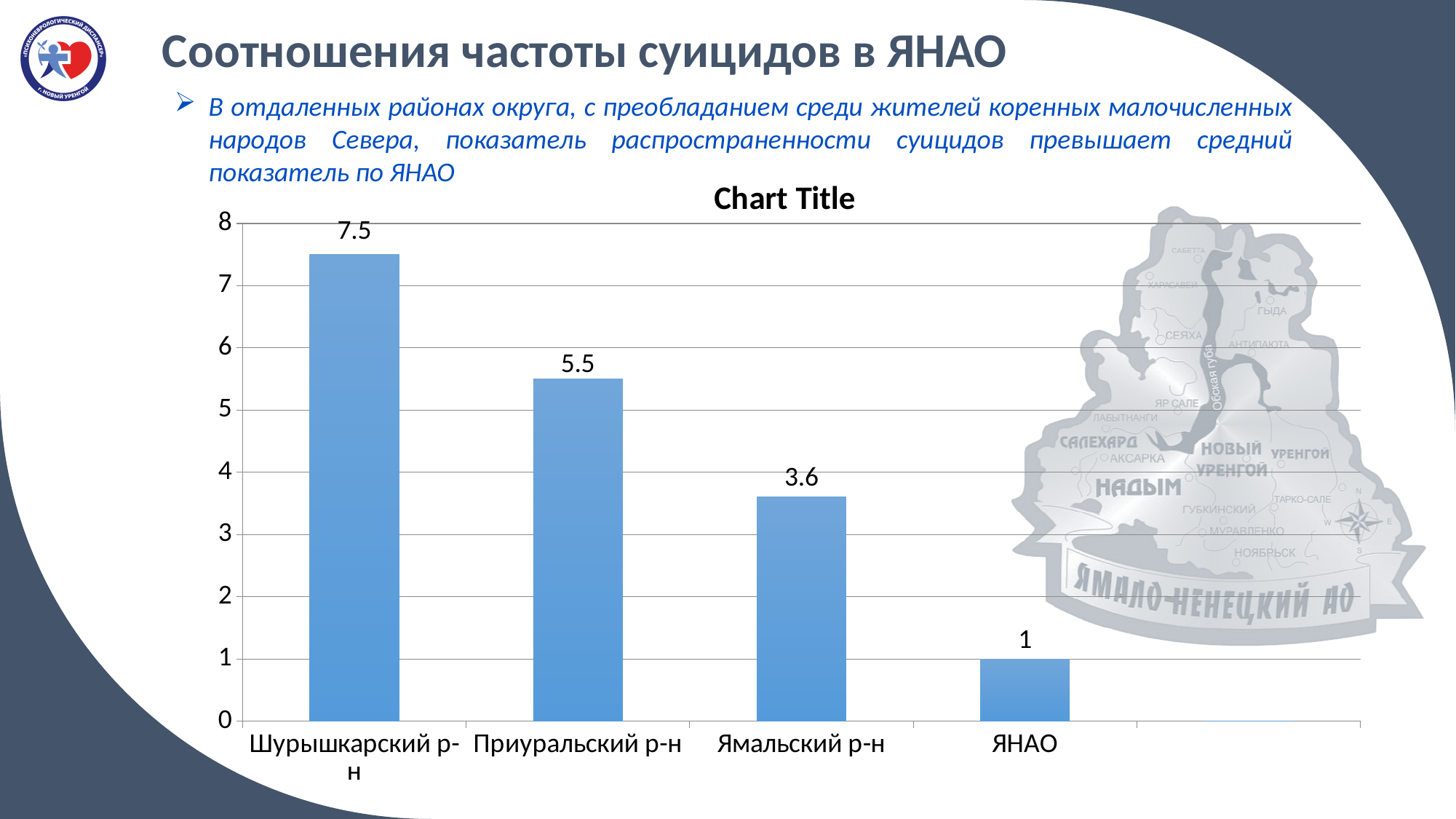
What kind of chart is shown on the slide? bar chart What is the value for Приуральский р-н? 5.5 Do the values rise or fall from left to right along the x axis? fall How many categories are shown on the chart? 4 Which category has the lowest value? ЯНАО What is the value for ЯНАО? 1 What is the value for Шурышкарский р-н? 7.5 What is the value for Ямальский р-н? 3.6 What is the difference between the values for Шурышкарский р-н and Приуральский р-н? 2 Which category has the highest value? Шурышкарский р-н Which is larger, the value for Приуральский р-н or the value for Ямальский р-н? Приуральский р-н What is the difference between the values for Ямальский р-н and ЯНАО? 2.6